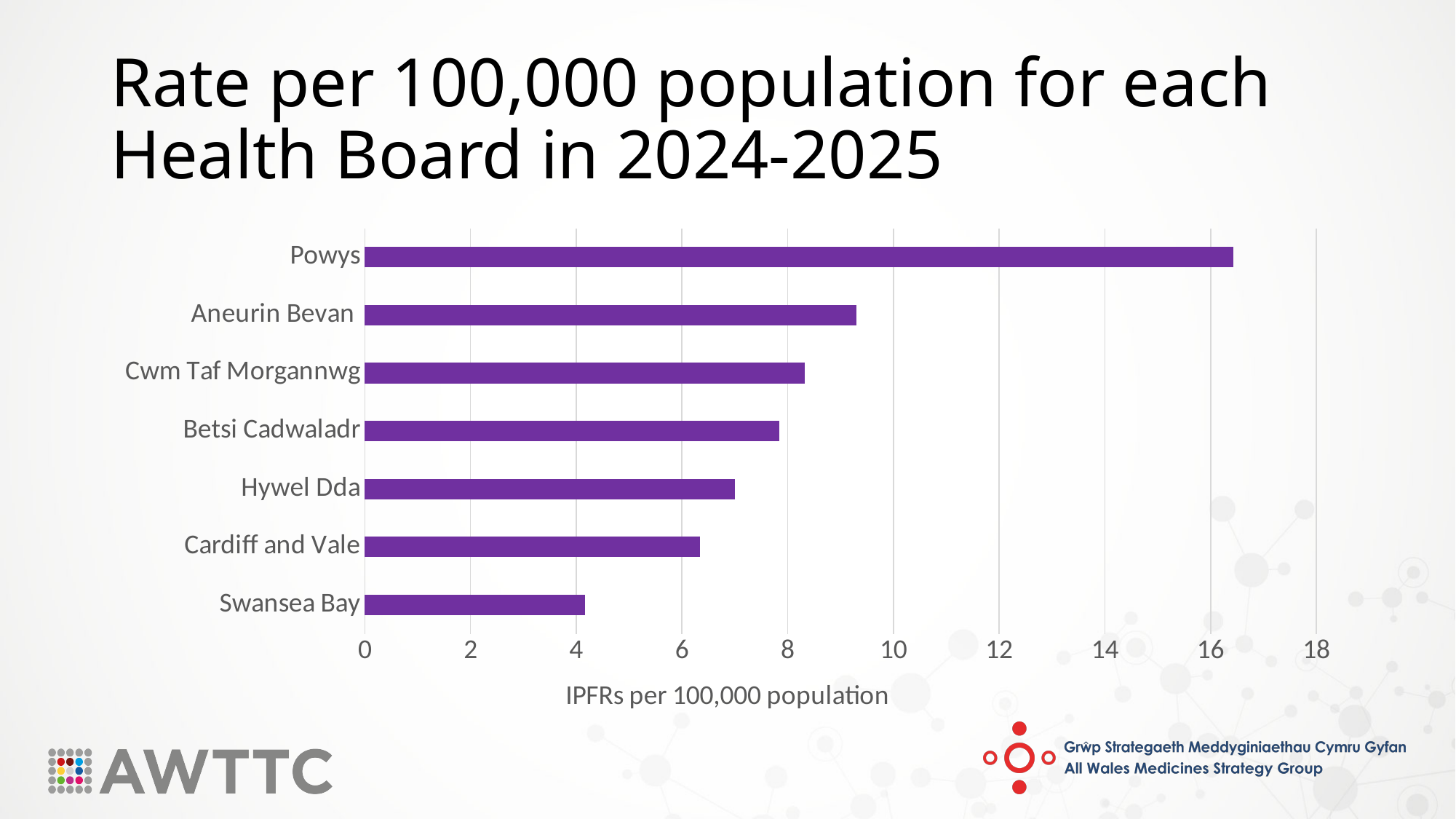
Is the value for Betsi Cadwaladr greater or less than 8? less How many health boards are shown in the chart? 7 Is the value for Swansea Bay greater or less than 6? less Is the value for Powys greater or less than 16? greater Which has a higher rate, Hywel Dda or Swansea Bay? Hywel Dda Which health board has the lowest rate per 100,000 population? Swansea Bay Which has a higher rate, Aneurin Bevan or Cwm Taf Morgannwg? Aneurin Bevan What is the label on the horizontal axis of the chart? IPFRs per 100,000 population What kind of chart is shown on the slide? Bar chart Which health board has the highest rate per 100,000 population? Powys